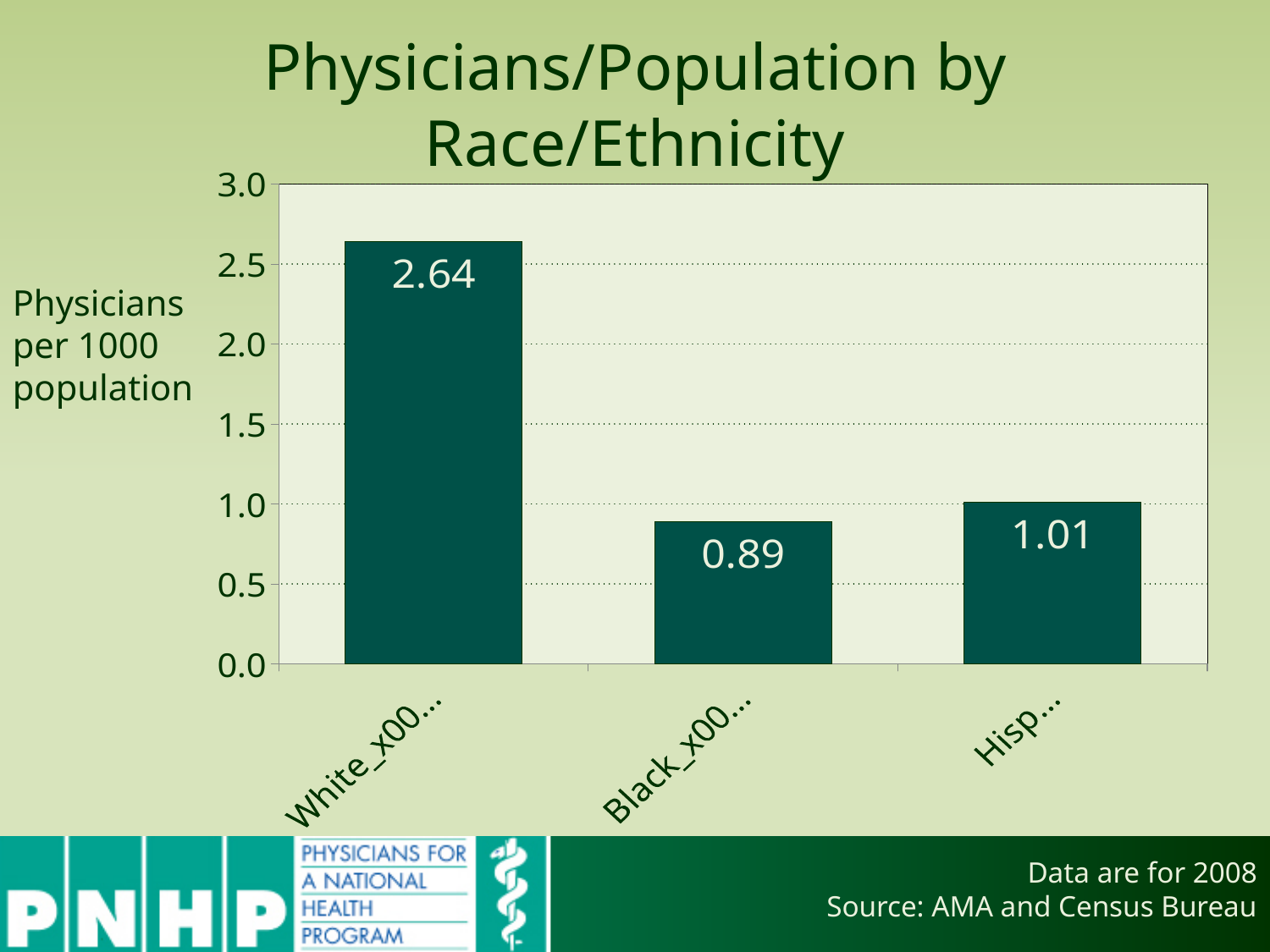
How many bars are shown in the chart? 3 What is the title of the chart? Physicians/Population by Race/Ethnicity What is the value of the bar labelled "Black"? 0.89 Which is larger, the value for the White bar or the value for the third bar ("Hisp...")? White What kind of chart is shown on the slide? bar chart What is the difference between the values for the third bar ("Hisp...") and the Black bar? 0.12 What is the value of the bar labelled "White"? 2.64 Which bar has the highest value? White Which bar has the lowest value? Black Is the value for the White bar greater or less than 2.5? greater What is the value of the third bar (labelled "Hisp...")? 1.01 What is the difference between the values for the White bar and the Black bar? 1.75